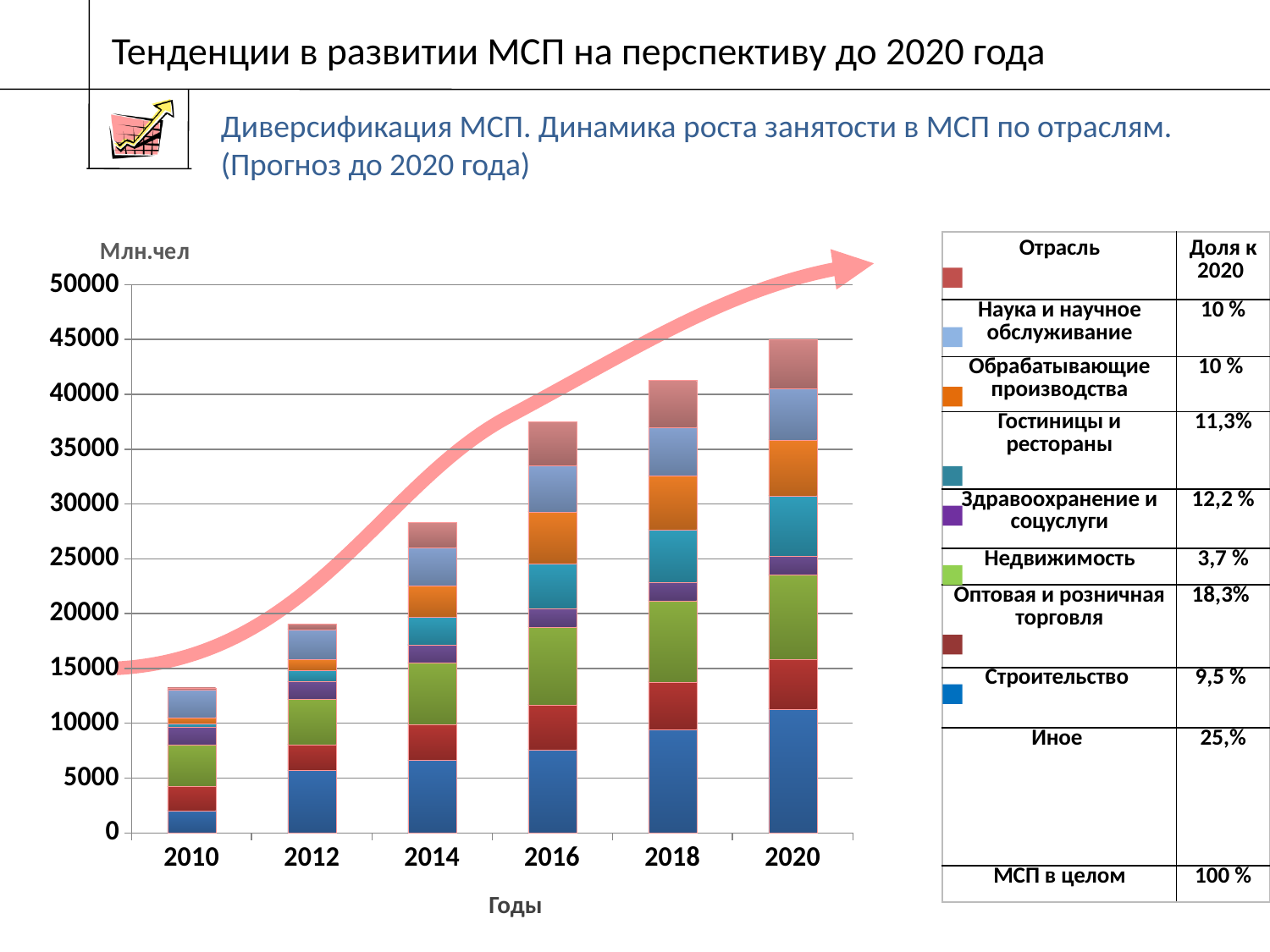
Is the total for 2010 greater or less than 15000? less Is the total for 2016 greater or less than 35000? greater Is the total for 2020 greater or less than 40000? greater What is the label on the horizontal axis of the chart? Годы How many years are shown on the x axis of the chart? 6 Which year has the larger total bar, 2014 or 2016? 2016 Which year has the shortest stacked bar in the chart? 2010 Which year has the tallest stacked bar in the chart? 2020 What kind of chart is shown on the slide? stacked bar chart Do the total bar heights rise or fall from 2010 to 2020? rise What is the label on the vertical axis of the chart? Млн.чел